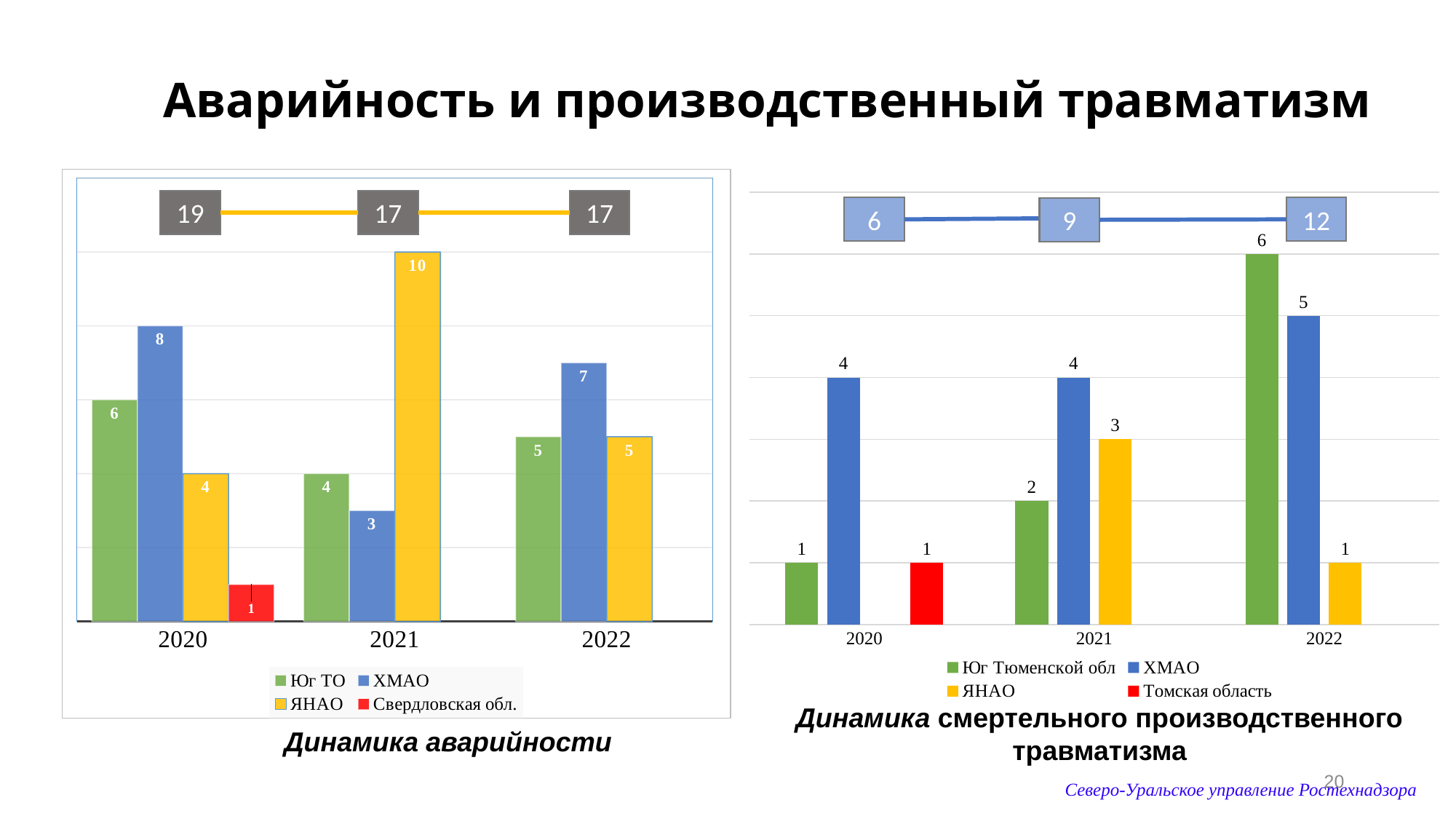
In the chart 'Динамика смертельного производственного травматизма', do the yearly totals shown above the bars rise or fall from 2020 to 2022? rise In the chart 'Динамика смертельного производственного травматизма', what is the value for ЯНАО in 2021? 3 In the chart 'Динамика смертельного производственного травматизма', which is larger in 2022: Юг Тюменской обл or ХМАО? Юг Тюменской обл What kind of chart is 'Динамика смертельного производственного травматизма'? bar chart In the chart 'Динамика аварийности', what is the difference between the ЯНАО value in 2021 and the ХМАО value in 2021? 7 In the chart 'Динамика смертельного производственного травматизма', what is the value for Юг Тюменской обл in 2022? 6 In the chart 'Динамика аварийности', how many series does the legend list? 4 In the chart 'Динамика аварийности', which series has the highest value in 2022? ХМАО In the chart 'Динамика смертельного производственного травматизма', what total is shown above the bars for 2022? 12 In the chart 'Динамика аварийности', what is the value for ХМАО in 2020? 8 In the chart 'Динамика аварийности', what is the value for ЯНАО in 2021? 10 In the chart 'Динамика аварийности', what total is shown above the bars for 2020? 19